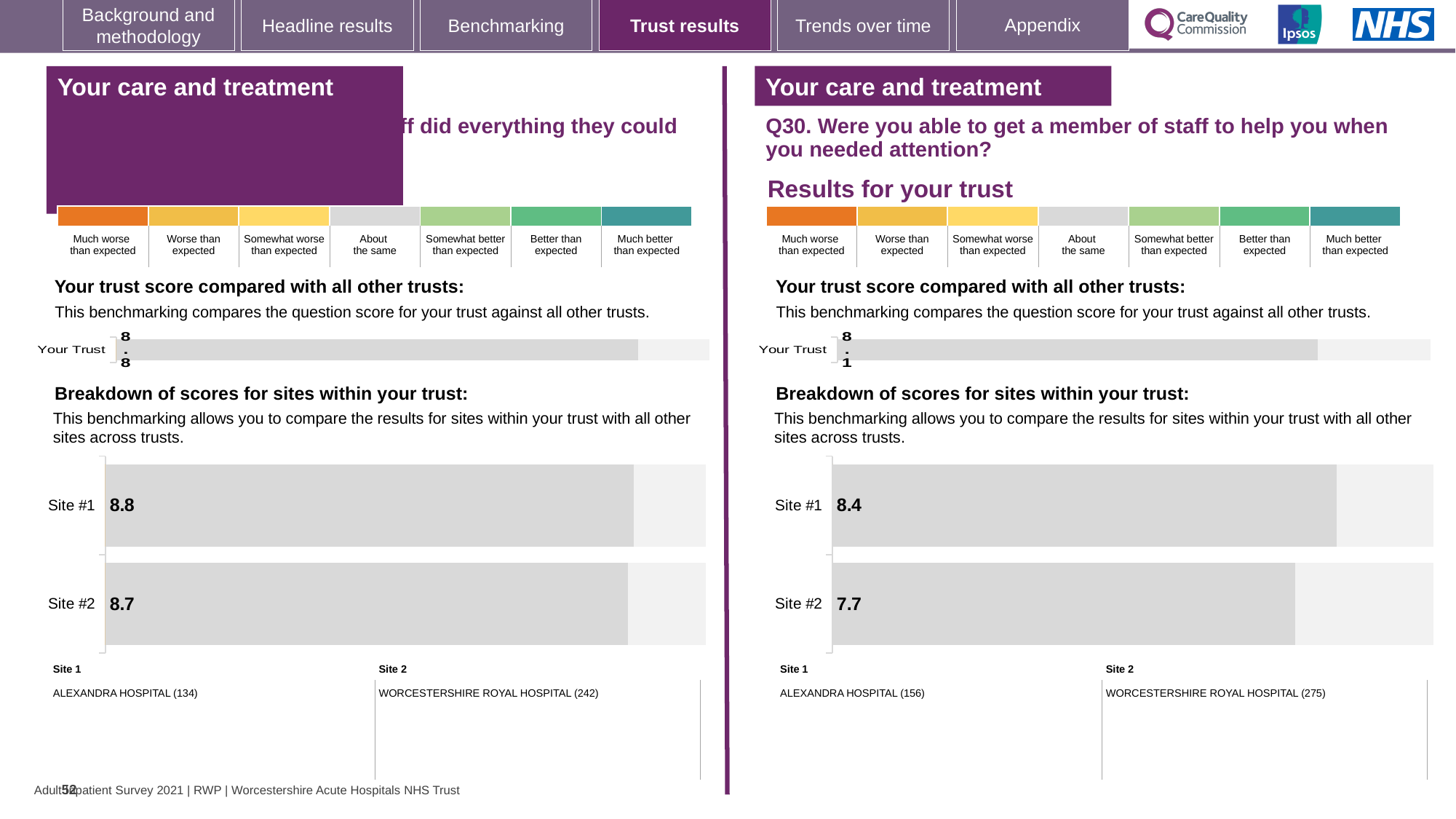
How many sites are shown in the breakdown of scores chart on the right-hand (Q30) panel? 2 On the left-hand panel, what is the difference between the Site #1 and Site #2 scores in the site breakdown chart? 0.1 On the right-hand (Q30) panel, which hospital is listed as Site 2 below the site breakdown chart? WORCESTERSHIRE ROYAL HOSPITAL (275) On the right-hand (Q30) panel, what is the 'Your Trust' score in the trust score comparison chart? 8.1 What type of chart is used for the breakdown of scores for sites within your trust on the right-hand (Q30) panel? Bar chart On the left-hand panel, what is the score shown for Site #1 in the breakdown of scores for sites within your trust? 8.8 On the right-hand (Q30) panel, what is the score shown for Site #2 in the breakdown of scores for sites within your trust? 7.7 On the right-hand (Q30) panel, which site has the higher score in the breakdown of scores for sites within your trust? Site #1 On the left-hand panel, what is the 'Your Trust' score in the trust score comparison chart? 8.8 On the right-hand (Q30) panel, what is the difference between the Site #1 and Site #2 scores in the site breakdown chart? 0.7 On the left-hand panel, what is the score shown for Site #2 in the breakdown of scores for sites within your trust? 8.7 On the right-hand (Q30) panel, what is the score shown for Site #1 in the breakdown of scores for sites within your trust? 8.4